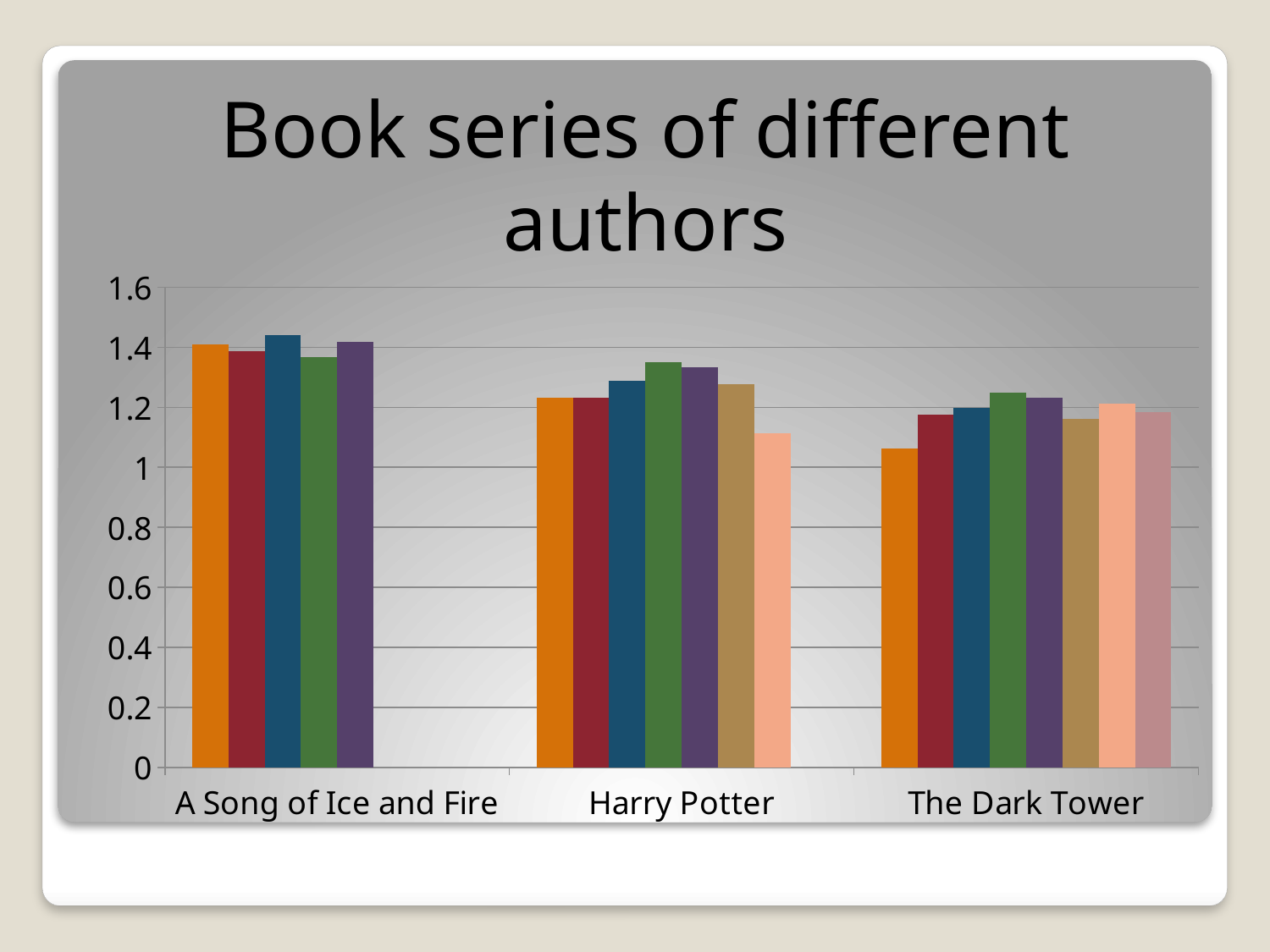
Is the value of the orange bar for A Song of Ice and Fire greater or less than 1.2? greater Is the value of the orange bar for The Dark Tower greater or less than 1.2? less Is the value of the light peach bar for Harry Potter greater or less than 1.2? less Which category contains the shortest bar in the chart? The Dark Tower How many categories are shown on the x axis of the chart? 3 Which is larger: the orange bar for A Song of Ice and Fire or the orange bar for The Dark Tower? A Song of Ice and Fire What is the highest value shown on the vertical axis of the chart? 1.6 What is the title of the chart? Book series of different authors Which category contains the tallest bar in the chart? A Song of Ice and Fire Do the orange bars rise or fall across the categories from left to right? fall What kind of chart is shown on the slide? bar chart